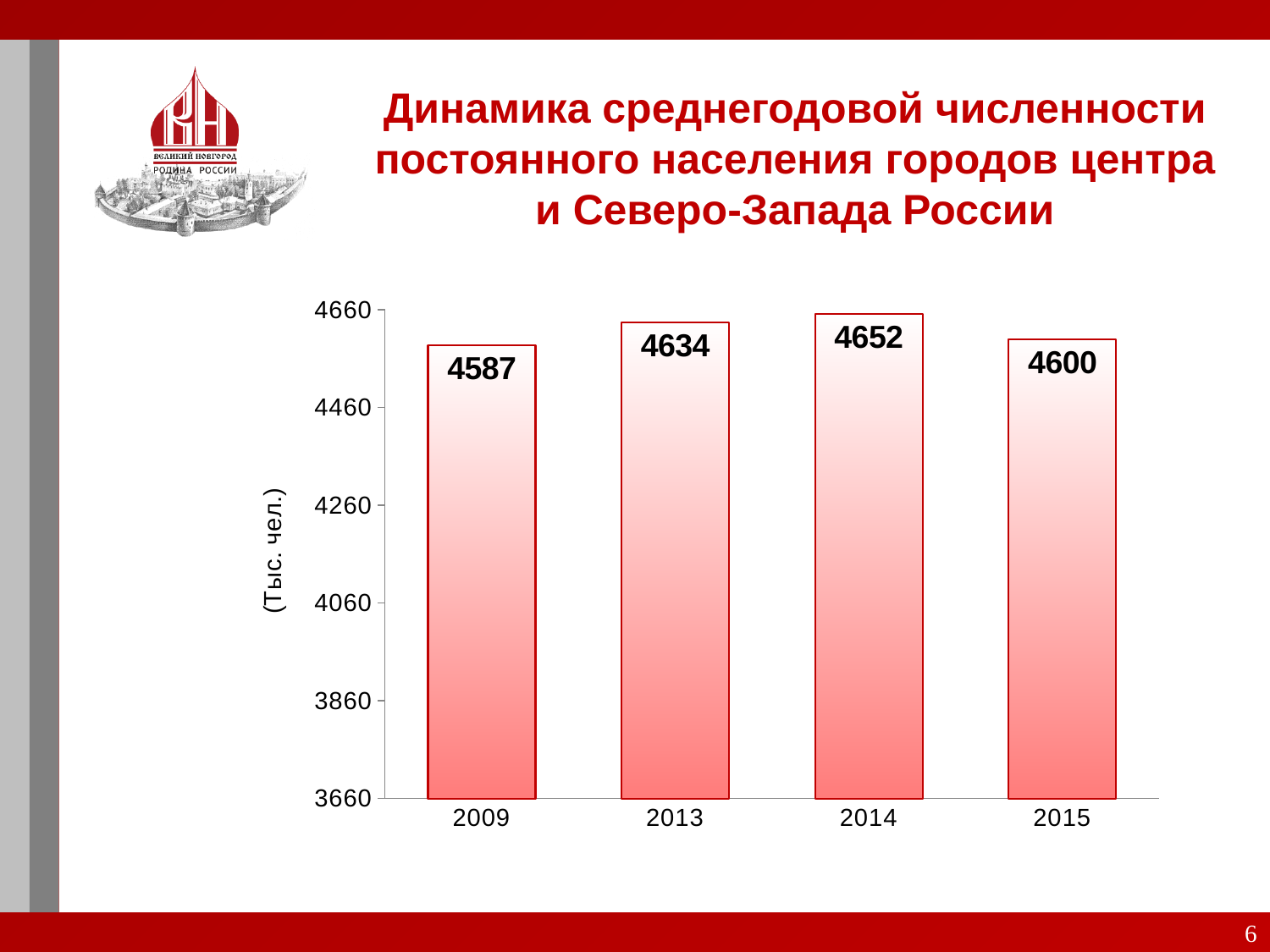
Which is larger, the value for 2013 or the value for 2015? 2013 What is the value for 2015? 4600 What is the difference between the values for 2014 and 2009? 65 Which year has the highest value? 2014 What is the value for 2014? 4652 Which year has the lowest value? 2009 What unit is given on the vertical axis label? Тыс. чел. What is the difference between the values for 2013 and 2015? 34 What kind of chart is shown on the slide? bar chart Is the value for 2009 greater or less than 4460? greater How many years are shown on the x axis? 4 What is the value for 2009? 4587